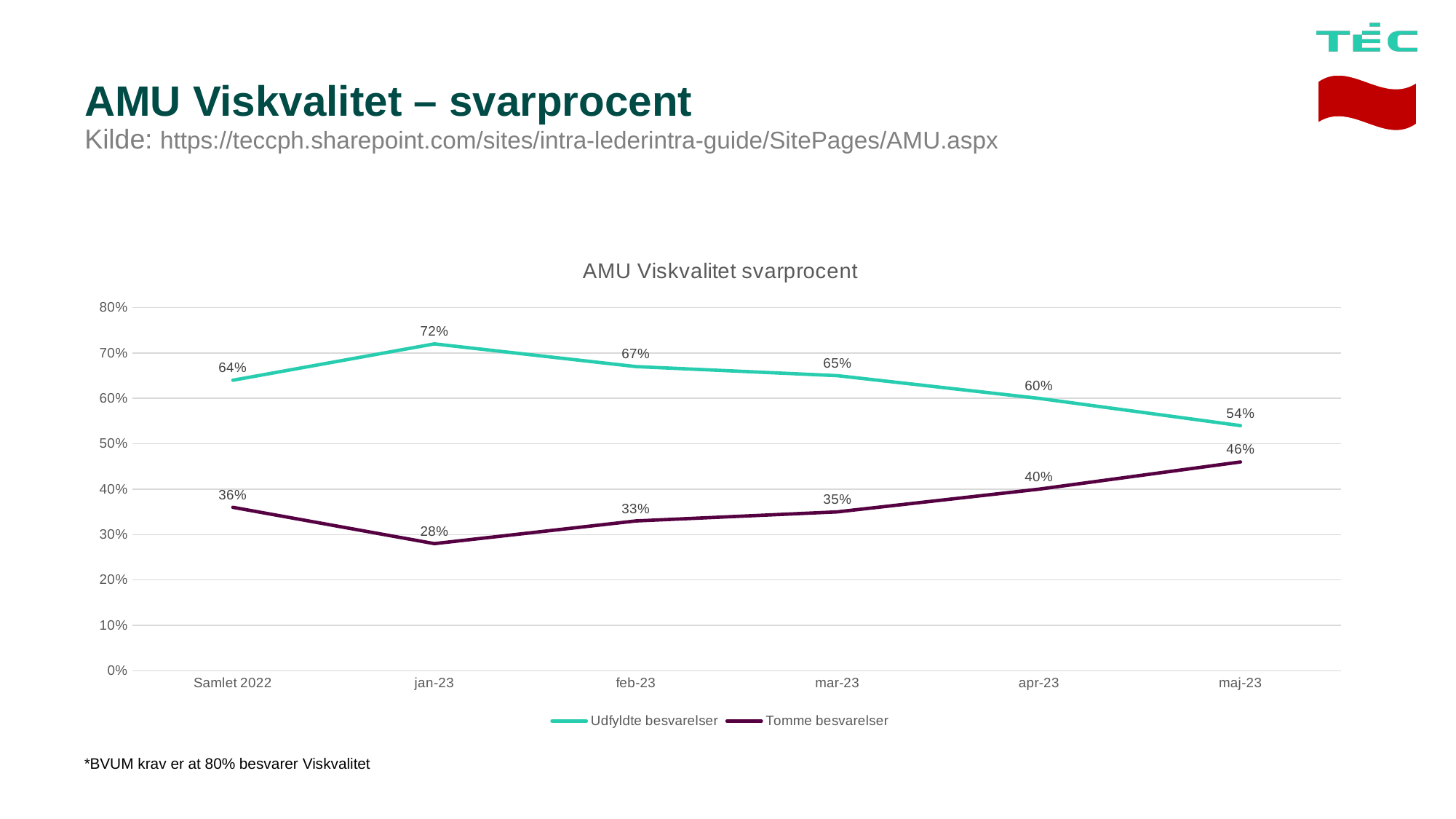
From jan-23 to maj-23, does Udfyldte besvarelser rise or fall? fall In which category is Tomme besvarelser lowest? jan-23 What is the difference between Udfyldte besvarelser and Tomme besvarelser in apr-23? 20% Which is larger in mar-23: Udfyldte besvarelser or Tomme besvarelser? Udfyldte besvarelser What is the value for Tomme besvarelser for Samlet 2022? 36% In which category is Udfyldte besvarelser highest? jan-23 How many series does the legend list? 2 What kind of chart is this? line chart What is the title of the chart? AMU Viskvalitet svarprocent How many categories are shown on the x axis? 6 What is the value for Udfyldte besvarelser in jan-23? 72% What is the value for Tomme besvarelser in maj-23? 46%